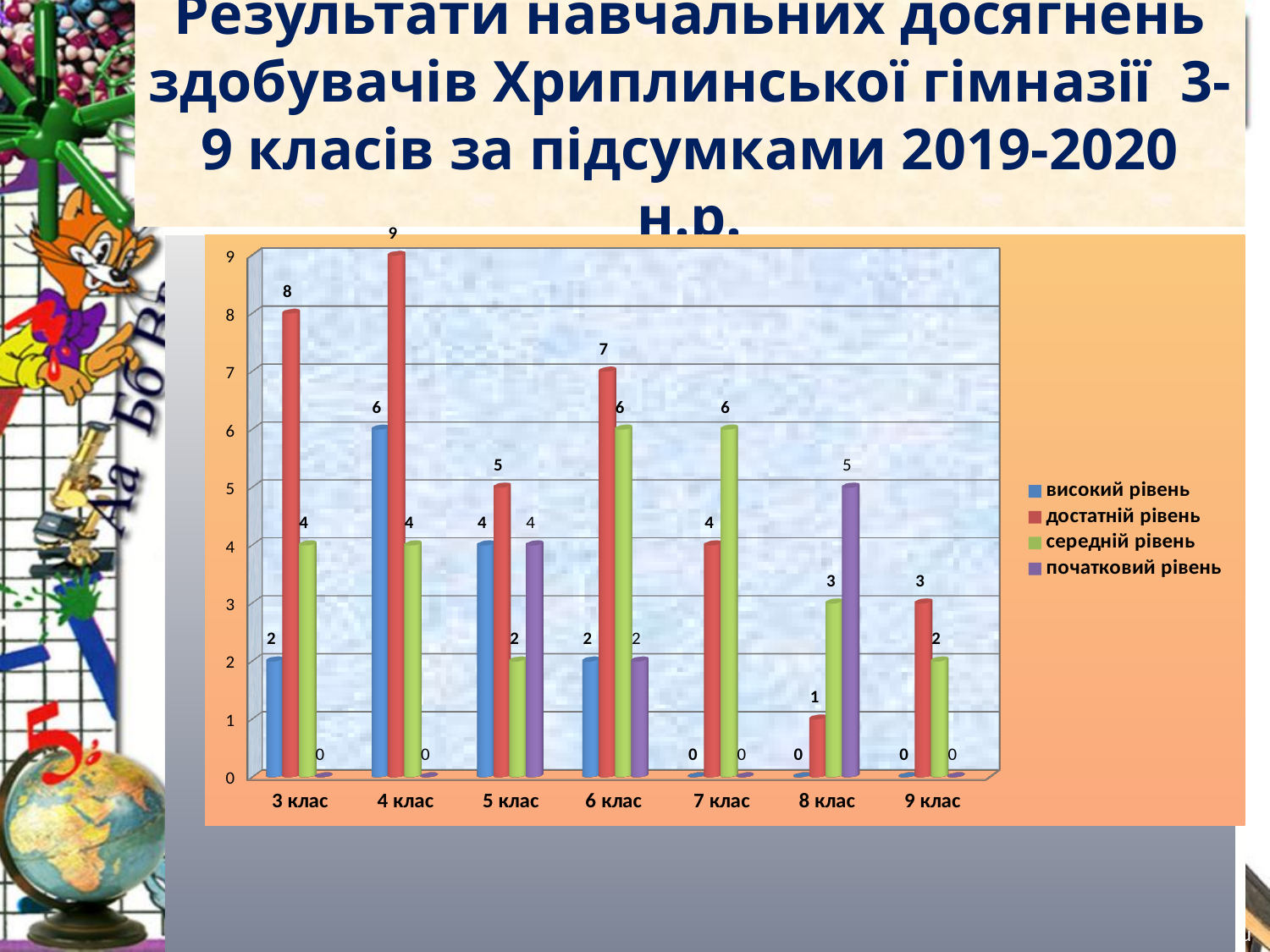
What is the value for середній рівень in 7 клас? 6 What is the value for високий рівень in 4 клас? 6 Which class has the lowest non-zero value for достатній рівень? 8 клас Which class has the highest value for достатній рівень? 4 клас In 6 клас, which is larger: достатній рівень or середній рівень? достатній рівень What is the value for початковий рівень in 8 клас? 5 How many series does the legend list? 4 What is the total of all four levels for 5 клас? 15 How many classes are shown on the x axis? 7 How many students in 3 клас are at достатній рівень? 8 What kind of chart is shown on the slide? bar chart What is the difference between достатній рівень and високий рівень in 3 клас? 6